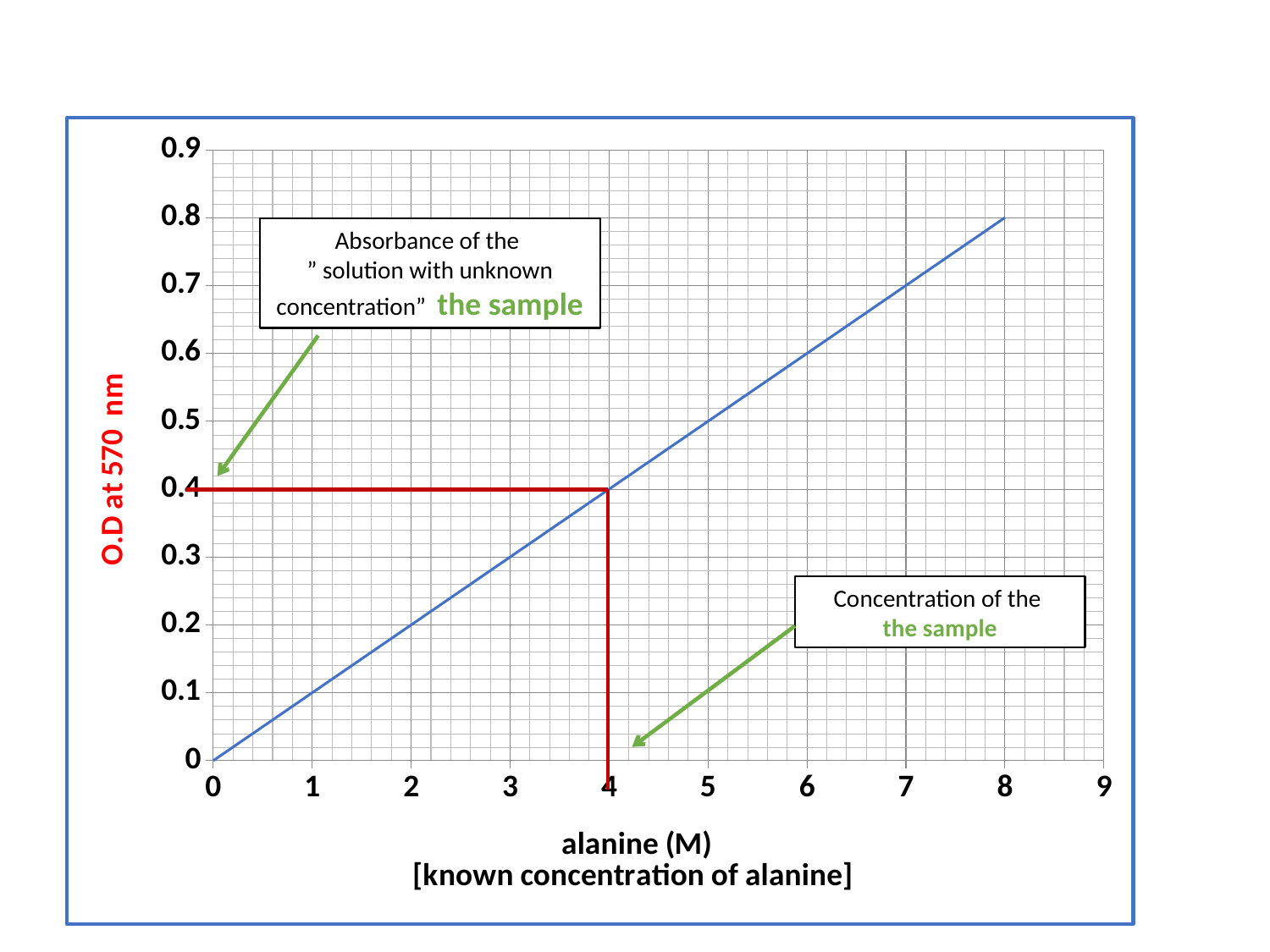
What is the O.D at 570 nm of the sample, as marked by the red line? 0.4 Is the O.D at 570 nm at an alanine concentration of 2 M greater or less than 0.3? less What is the O.D at 570 nm where the blue line ends at an alanine concentration of 8 M? 0.8 Does the O.D at 570 nm rise or fall as the alanine concentration increases? rise Which has a higher O.D at 570 nm: an alanine concentration of 7 M or 3 M? 7 M What is the concentration of the sample (in M) indicated by the red vertical line? 4 Is the O.D at 570 nm at an alanine concentration of 6 M greater or less than 0.5? greater What is the difference in O.D at 570 nm between an alanine concentration of 8 M and the sample at 4 M? 0.4 What is the label of the x axis? alanine (M) [known concentration of alanine] What is the O.D at 570 nm at an alanine concentration of 0 M? 0 What is the label of the y axis? O.D at 570 nm What kind of chart is shown on the slide? line chart